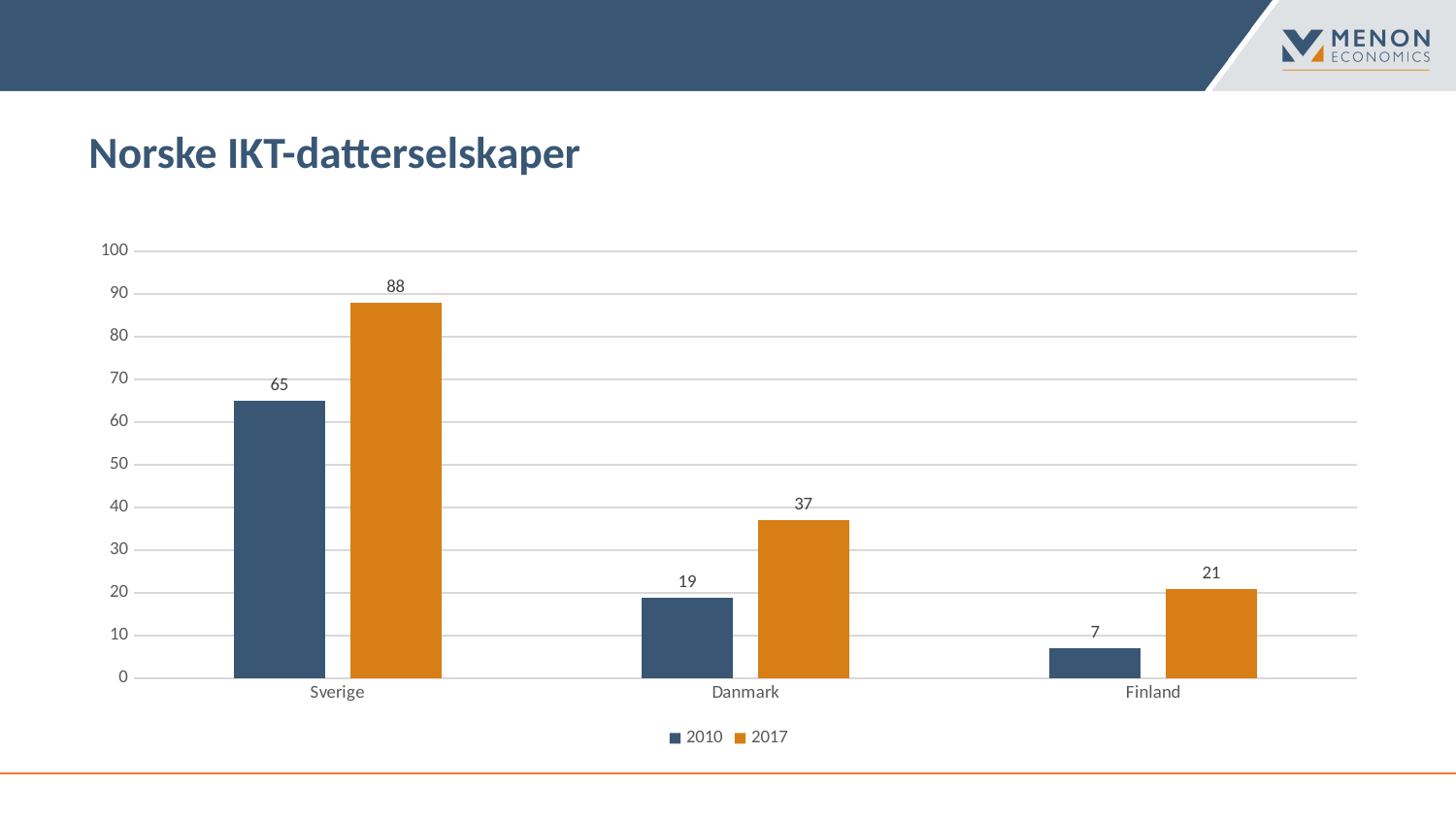
What is the difference between the 2017 and 2010 values for Sverige? 23 What kind of chart is shown on the slide? bar chart What is the value for Finland in 2010? 7 Which is larger: the 2010 value for Danmark or the 2017 value for Finland? 2017 value for Finland Which country has the lowest value in 2010? Finland How many series does the legend list? 2 What is the difference between the 2017 values for Danmark and Finland? 16 How many countries are shown on the x axis? 3 Which country has the highest value in 2017? Sverige Is the 2017 value for Danmark greater or less than 40? less What is the value for Sverige in 2017? 88 What is the value for Danmark in 2010? 19